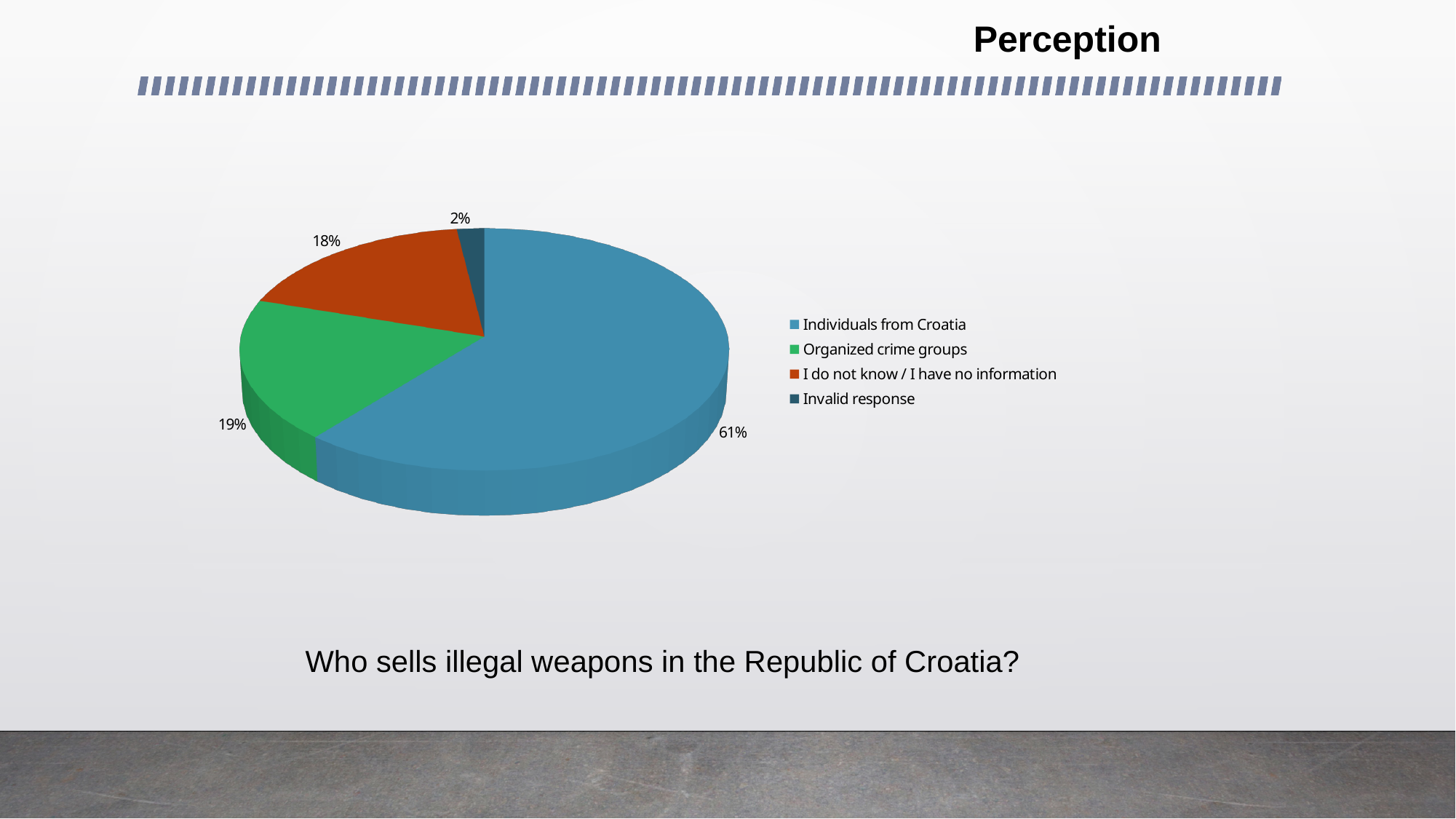
What share of the pie is labelled for Individuals from Croatia? 61% Which category has the largest slice of the pie? Individuals from Croatia What colour is the slice for Organized crime groups? Green What percentage is shown for Invalid response? 2% How many categories does the legend list? 4 What percentage is shown for the slice 'I do not know / I have no information'? 18% What is the difference in percentage points between Individuals from Croatia and Organized crime groups? 42 What kind of chart is shown on the slide? Pie chart Which is larger: the slice for Organized crime groups or the slice for Invalid response? Organized crime groups What percentage is shown for Organized crime groups? 19% What question does the chart answer, according to the text below it? Who sells illegal weapons in the Republic of Croatia? Which category has the smallest slice of the pie? Invalid response